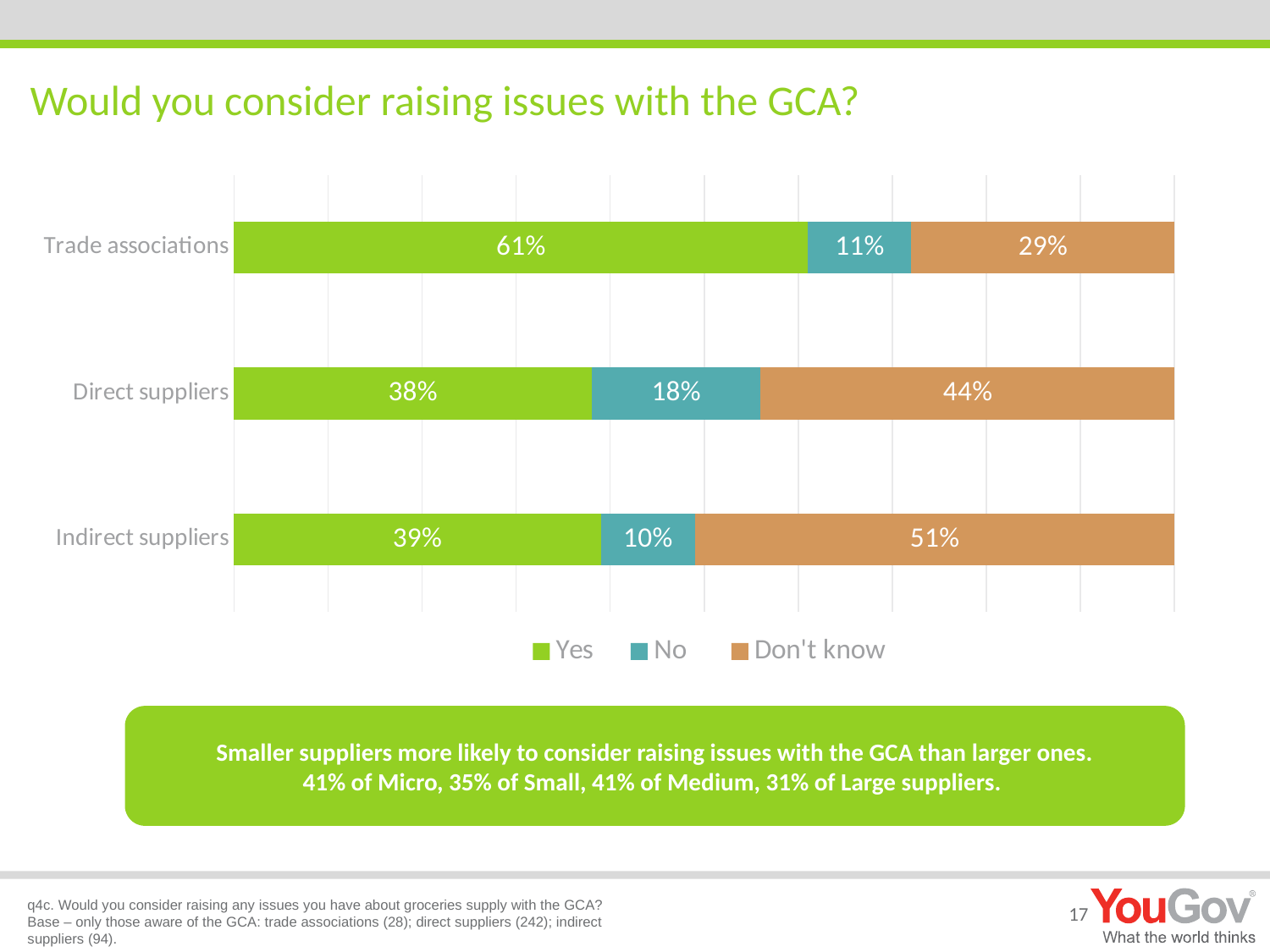
What percentage of indirect suppliers answered "No"? 10% What percentage of direct suppliers answered "Don't know"? 44% What kind of chart is shown on the slide? Stacked bar chart Which legend entry is shown in orange? Don't know What is the total of the three segments for the direct suppliers bar? 100% What percentage of trade associations answered "Yes"? 61% How many series does the legend list? 3 How many groups are shown on the chart? 3 Which is larger: the "No" percentage for direct suppliers or for trade associations? Direct suppliers Which group has the highest "Yes" percentage? Trade associations What is the difference between the "Don't know" percentages for indirect suppliers and trade associations? 22% Which group has the lowest "No" percentage? Indirect suppliers